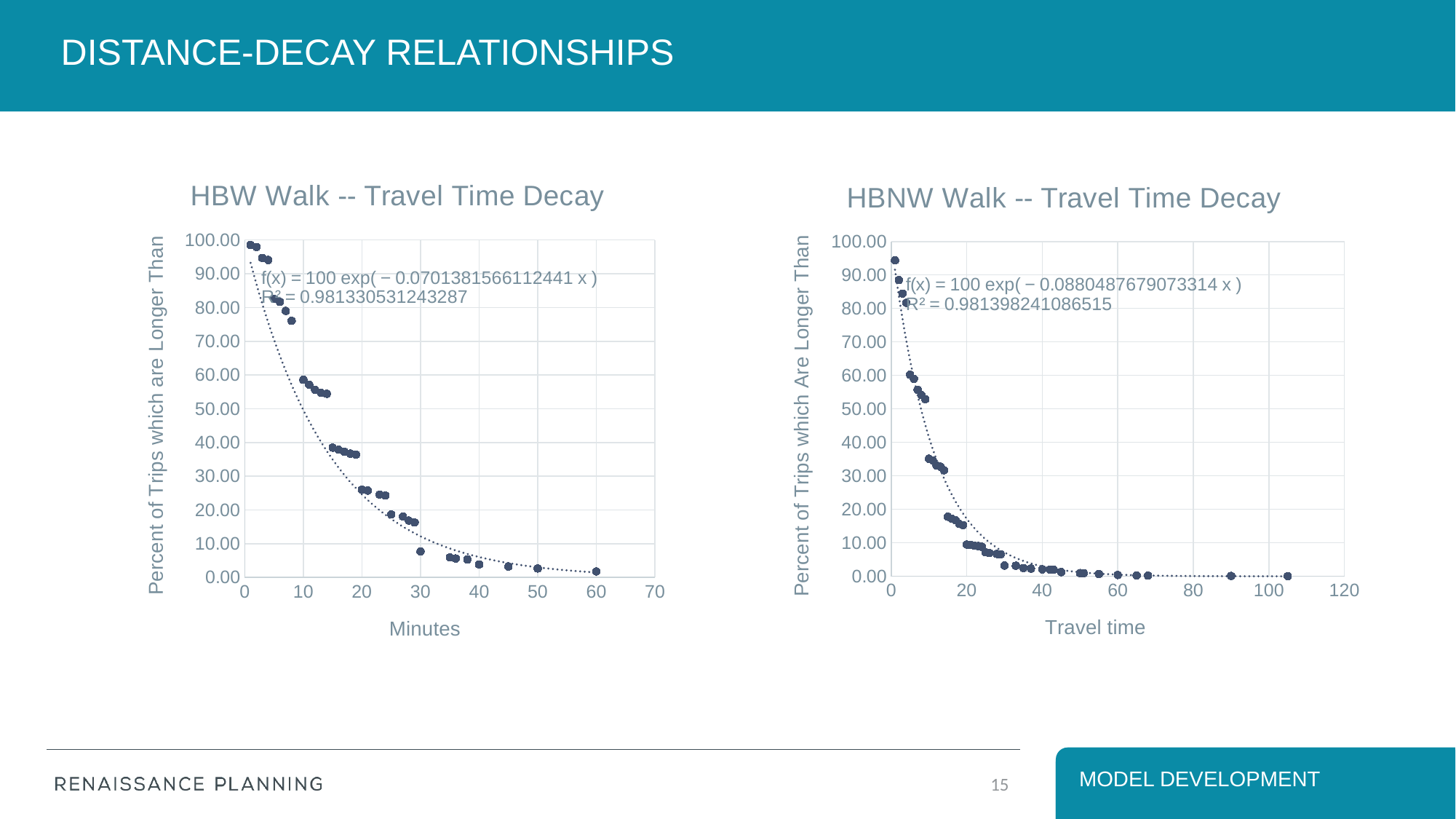
In the HBW Walk -- Travel Time Decay chart, is the value at 30 minutes greater or less than 10? less In the HBW Walk -- Travel Time Decay chart, do the values rise or fall as minutes increase? fall In the HBNW Walk -- Travel Time Decay chart, is the value at 5 travel time greater or less than 50? greater In the HBW Walk -- Travel Time Decay chart, is the value at 10 minutes greater or less than 50? greater In the HBNW Walk -- Travel Time Decay chart, do the values rise or fall as travel time increases? fall What is the x-axis title of the HBNW Walk -- Travel Time Decay chart? Travel time What is the R² value shown on the HBW Walk -- Travel Time Decay chart? 0.981330531243287 What kind of chart is the HBW Walk -- Travel Time Decay chart? scatter chart What kind of chart is the HBNW Walk -- Travel Time Decay chart? scatter chart